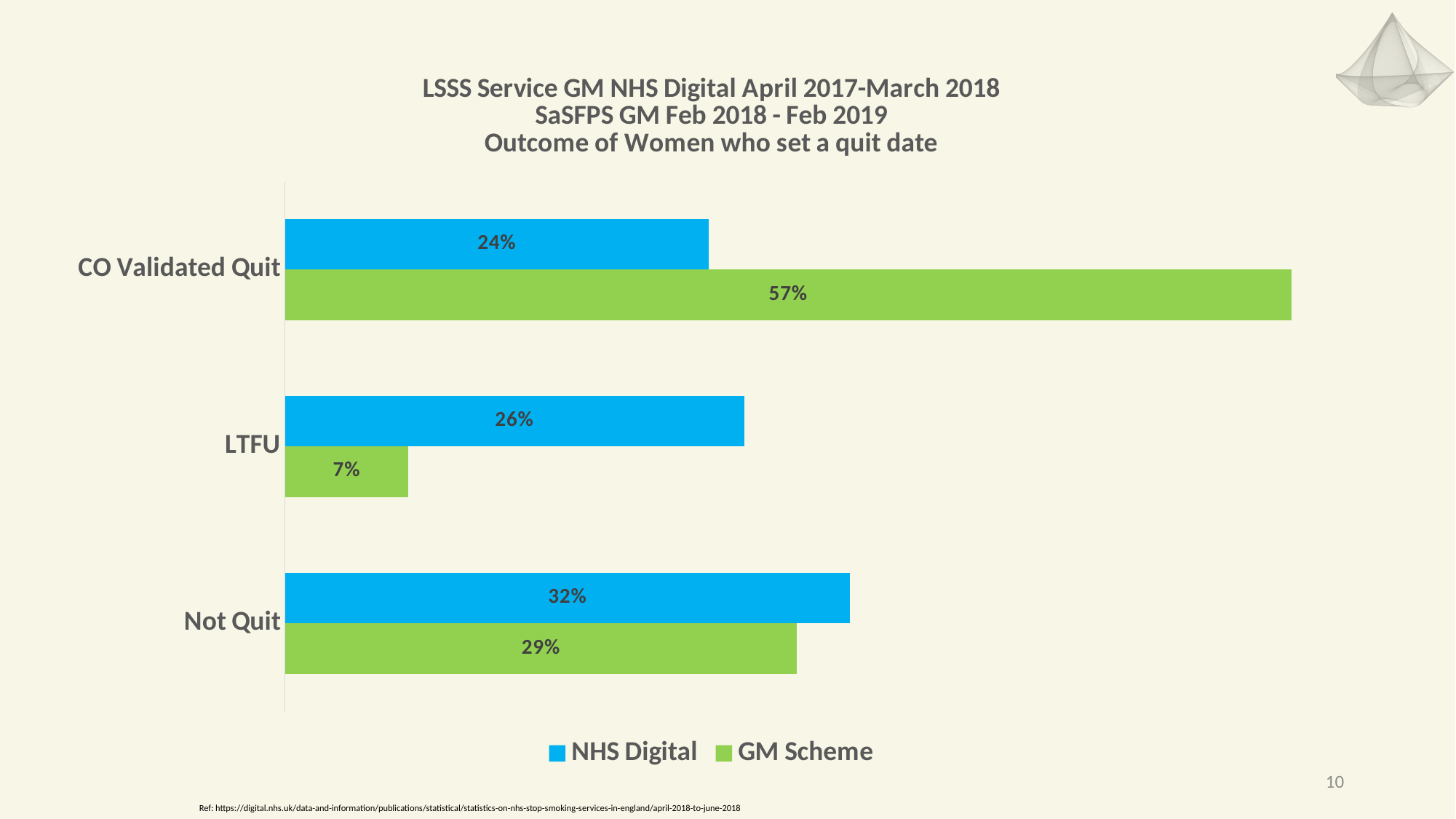
What is the GM Scheme value for Not Quit? 29% What is the NHS Digital value for CO Validated Quit? 24% How many categories are shown on the chart? 3 Which category has the lowest GM Scheme value? LTFU Which category has the highest GM Scheme value? CO Validated Quit What is the difference between the GM Scheme and NHS Digital values for CO Validated Quit? 33% What is the GM Scheme value for CO Validated Quit? 57% How many series does the legend list? 2 What is the NHS Digital value for LTFU? 26% For LTFU, which series has the larger value, NHS Digital or GM Scheme? NHS Digital What kind of chart is shown on the slide? Bar chart Which category has the highest NHS Digital value? Not Quit